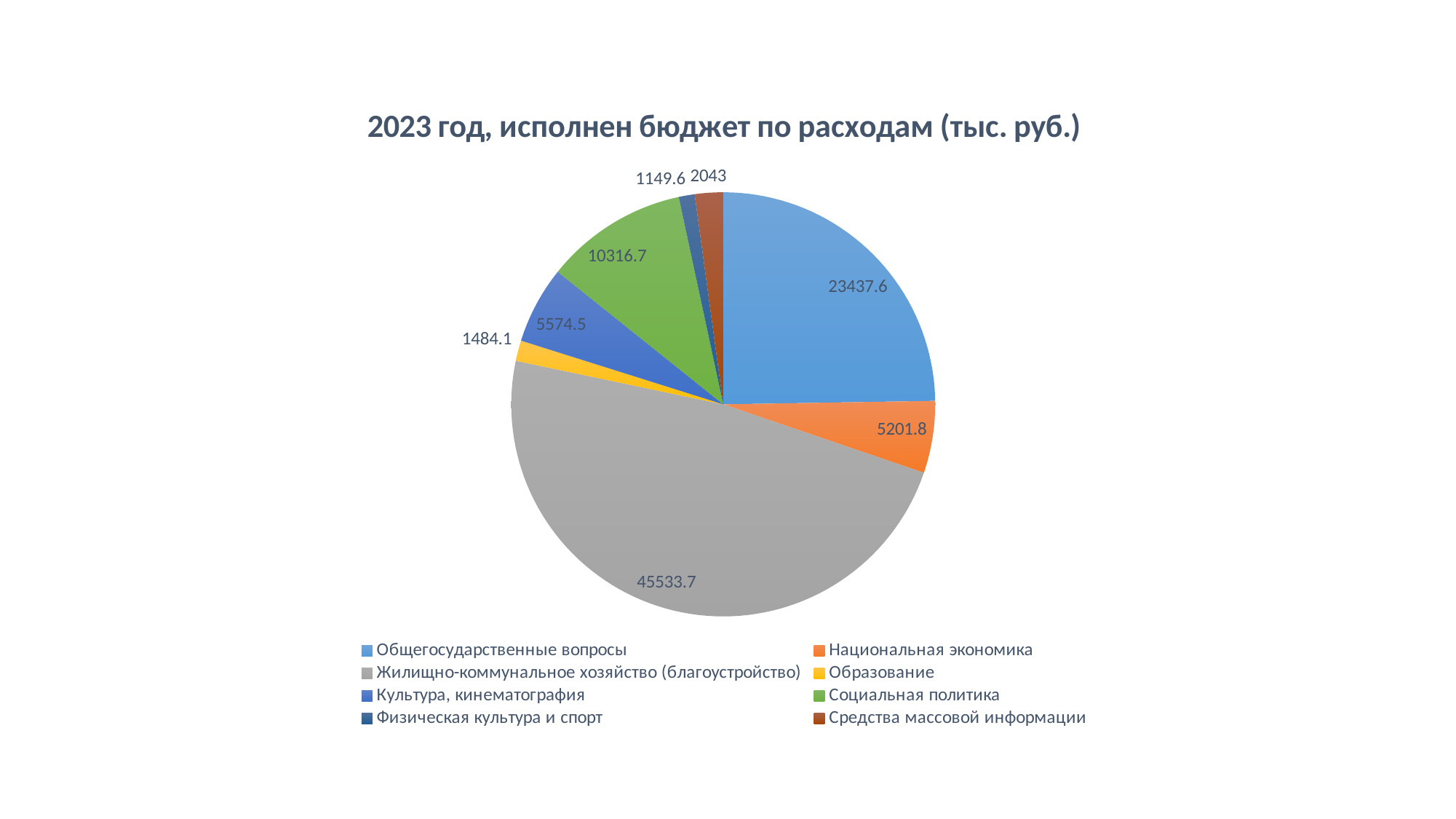
What is the difference between the values for Жилищно-коммунальное хозяйство (благоустройство) and Общегосударственные вопросы? 22096.1 What is the title of the chart? 2023 год, исполнен бюджет по расходам (тыс. руб.) Which category has the largest slice of the pie? Жилищно-коммунальное хозяйство (благоустройство) What is the value for Жилищно-коммунальное хозяйство (благоустройство)? 45533.7 What is the value for Средства массовой информации? 2043 What is the value for Общегосударственные вопросы? 23437.6 What is the value for Физическая культура и спорт? 1149.6 What is the value for Социальная политика? 10316.7 What type of chart is shown on the slide? Pie chart How many categories does the pie chart have? 8 Which category has the smallest slice of the pie? Физическая культура и спорт Which is larger: Культура, кинематография or Национальная экономика? Культура, кинематография